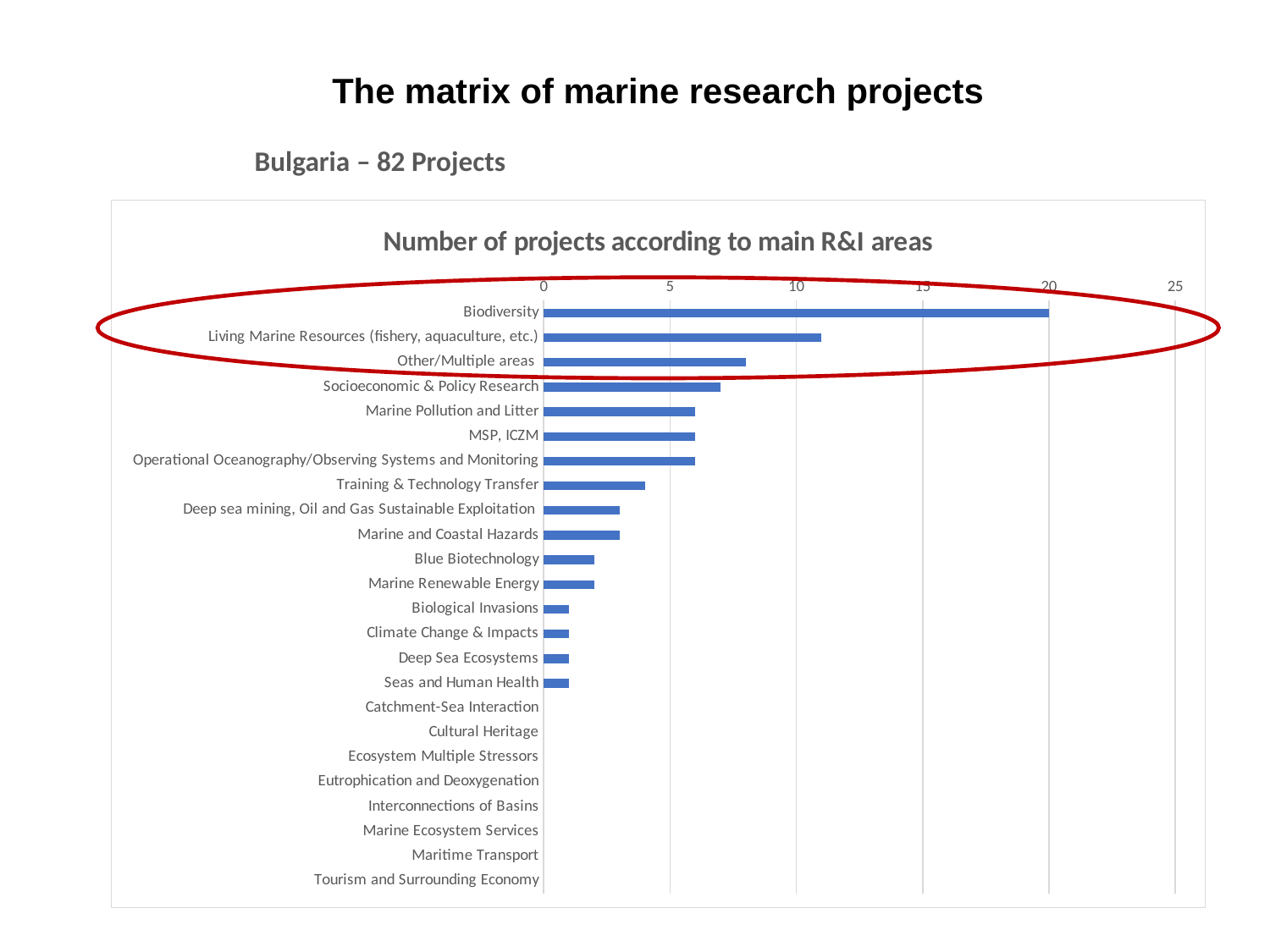
Which has more projects, Socioeconomic & Policy Research or Blue Biotechnology? Socioeconomic & Policy Research Which has more projects, Biodiversity or Living Marine Resources (fishery, aquaculture, etc.)? Biodiversity Is the value for Other/Multiple areas greater or less than 10? less What kind of chart is shown on the slide? bar chart What is the highest value shown on the chart's value axis? 25 Do the bar values increase or decrease going from the top category to the bottom category? decrease Which R&I area has the highest number of projects? Biodiversity Is the value for Training & Technology Transfer greater or less than 5? less How many R&I area categories are listed on the chart? 24 Is the value for Living Marine Resources (fishery, aquaculture, etc.) greater or less than 10? greater How many projects are shown for Biodiversity? 20 What is the title of the chart? Number of projects according to main R&I areas